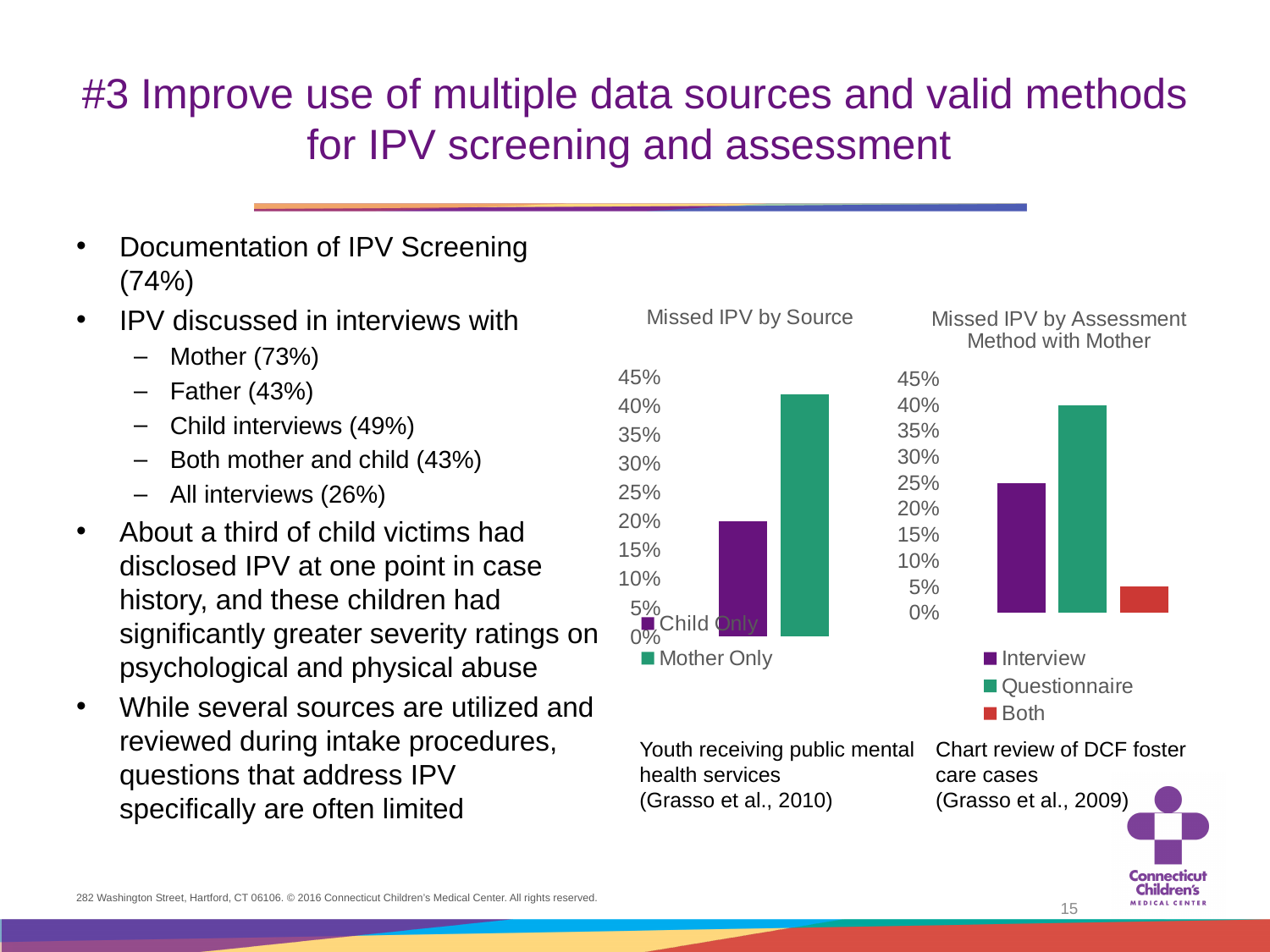
How many series does the legend of the 'Missed IPV by Source' chart list? 2 In the 'Missed IPV by Source' chart, is the value for Child Only greater or less than 30%? less In the 'Missed IPV by Source' chart, is the value for Mother Only greater or less than 35%? greater How many series does the legend of the 'Missed IPV by Assessment Method with Mother' chart list? 3 In the 'Missed IPV by Source' chart, which series has the higher value, Child Only or Mother Only? Mother Only In the 'Missed IPV by Assessment Method with Mother' chart, is the value for Both greater or less than 10%? less What is the maximum value shown on the vertical axis of the 'Missed IPV by Assessment Method with Mother' chart? 45% What kind of chart is 'Missed IPV by Source'? Bar chart In the 'Missed IPV by Assessment Method with Mother' chart, which assessment method has the highest missed IPV value? Questionnaire In the 'Missed IPV by Assessment Method with Mother' chart, which assessment method has the lowest missed IPV value? Both In the 'Missed IPV by Assessment Method with Mother' chart, which is larger, Interview or Questionnaire? Questionnaire